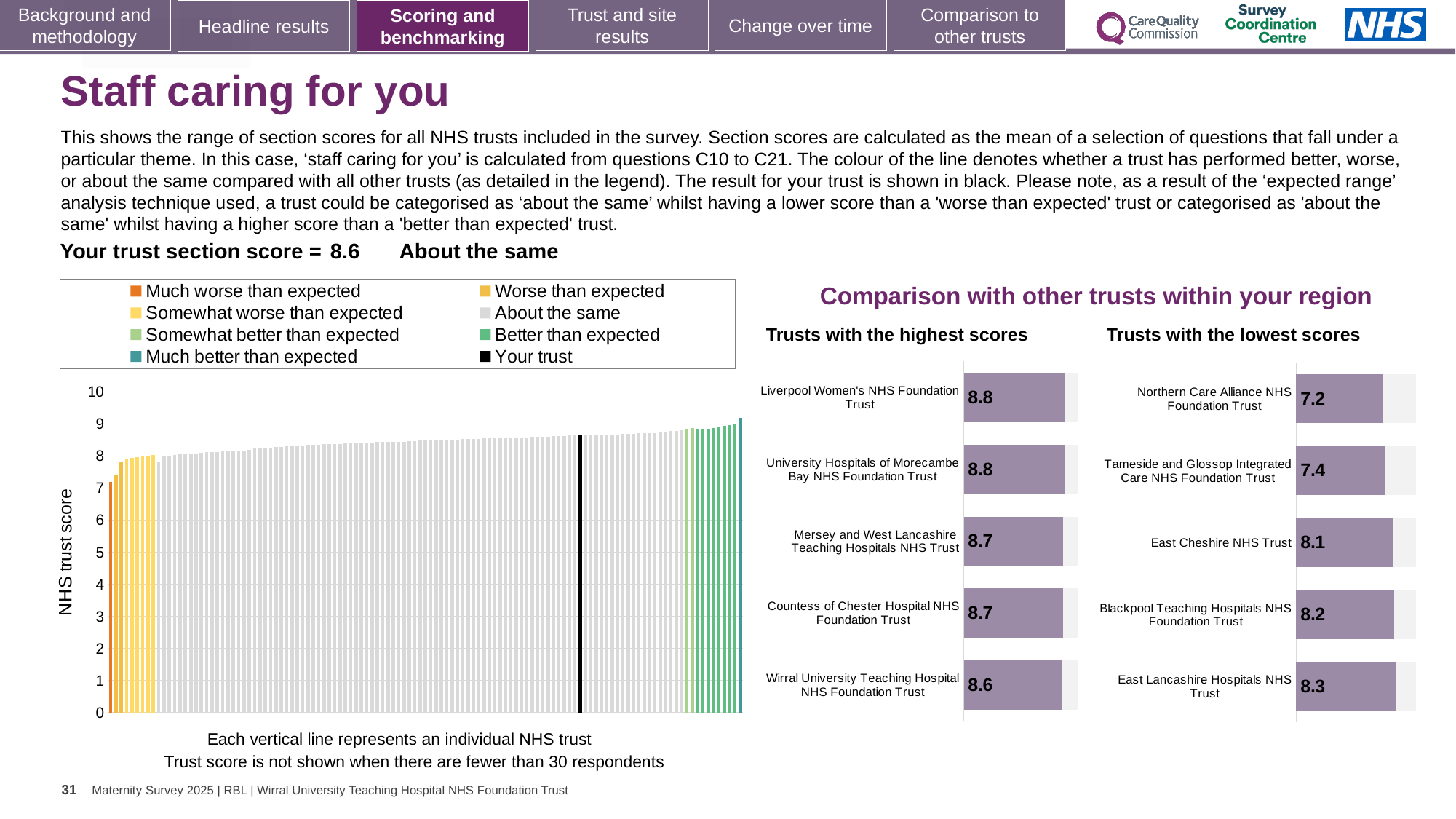
In the 'Trusts with the lowest scores' chart, which trust has the highest score? East Lancashire Hospitals NHS Trust In the 'Trusts with the lowest scores' chart, which trust has the lowest score? Northern Care Alliance NHS Foundation Trust In the 'Trusts with the lowest scores' chart, what is the score for East Cheshire NHS Trust? 8.1 How many trusts are shown in the 'Trusts with the highest scores' chart? 5 In the 'Trusts with the highest scores' chart, what is the score for Liverpool Women's NHS Foundation Trust? 8.8 How many entries does the legend of the NHS trust score chart on the left list? 8 In the 'Trusts with the highest scores' chart, what is the score for Wirral University Teaching Hospital NHS Foundation Trust? 8.6 In the 'Trusts with the lowest scores' chart, what is the score for Northern Care Alliance NHS Foundation Trust? 7.2 What kind of chart is the NHS trust score chart on the left of the slide? Bar chart In the 'Trusts with the lowest scores' chart, what is the difference between the scores of East Lancashire Hospitals NHS Trust and Northern Care Alliance NHS Foundation Trust? 1.1 In the 'Trusts with the highest scores' chart, what is the difference between the scores of Liverpool Women's NHS Foundation Trust and Wirral University Teaching Hospital NHS Foundation Trust? 0.2 In the 'Trusts with the lowest scores' chart, which has the larger score: Tameside and Glossop Integrated Care NHS Foundation Trust or Blackpool Teaching Hospitals NHS Foundation Trust? Blackpool Teaching Hospitals NHS Foundation Trust